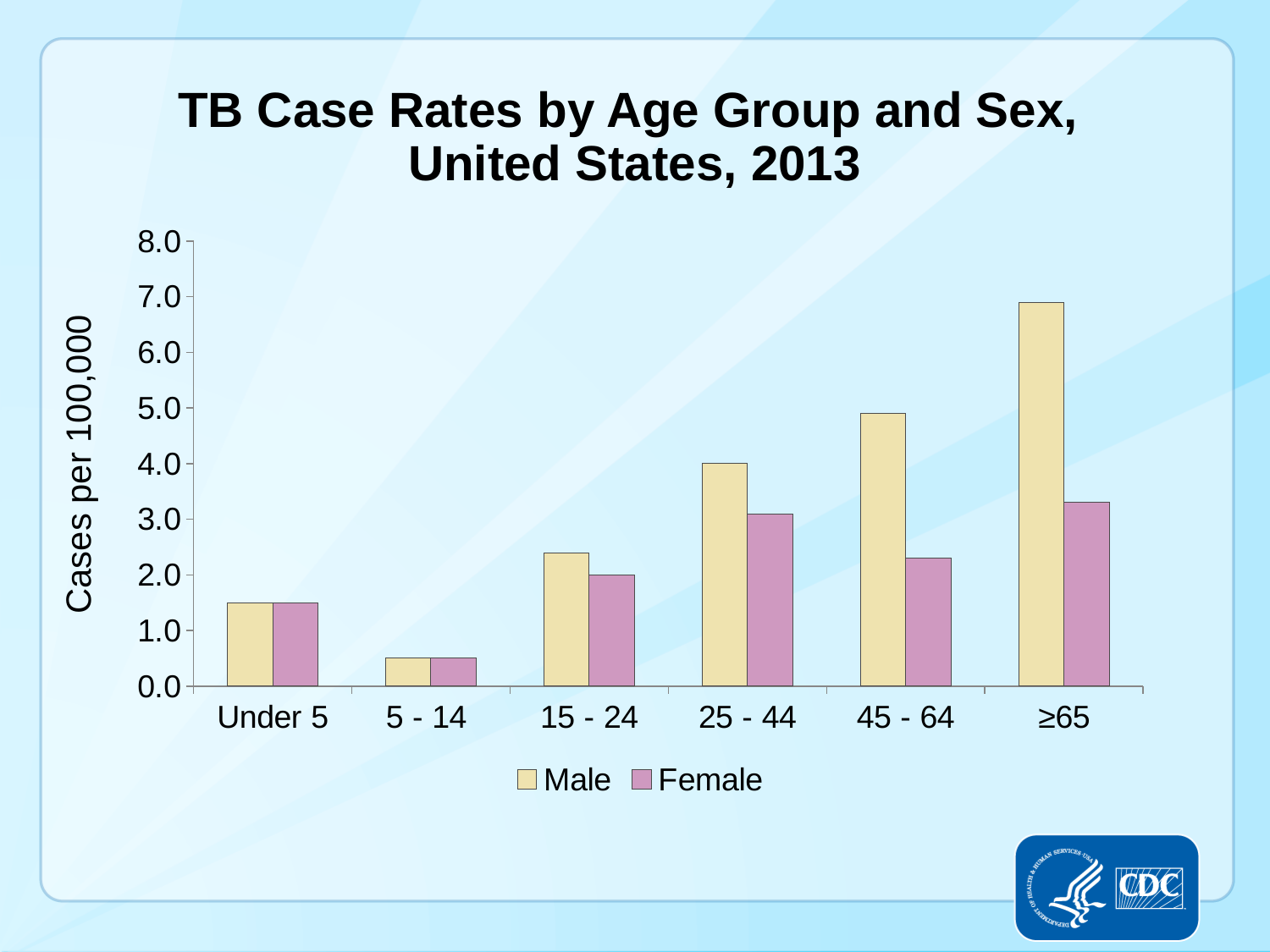
What kind of chart is shown on the slide? bar chart Which age group has the lowest Male TB case rate? 5 - 14 How many age groups are shown on the x axis? 6 Do the Male case rates rise or fall from the 5 - 14 age group to the ≥65 age group? rise Is the Female case rate for the 45 - 64 age group greater or less than 3.0? less In the 45 - 64 age group, which is larger, the Male or the Female case rate? Male Is the Male case rate for the 5 - 14 age group greater or less than 1.0? less Which age group has the highest Female TB case rate? ≥65 Is the Male case rate for the ≥65 age group greater or less than 6.0? greater How many series does the legend list? 2 Which age group has the highest Male TB case rate? ≥65 What is the label on the y axis? Cases per 100,000